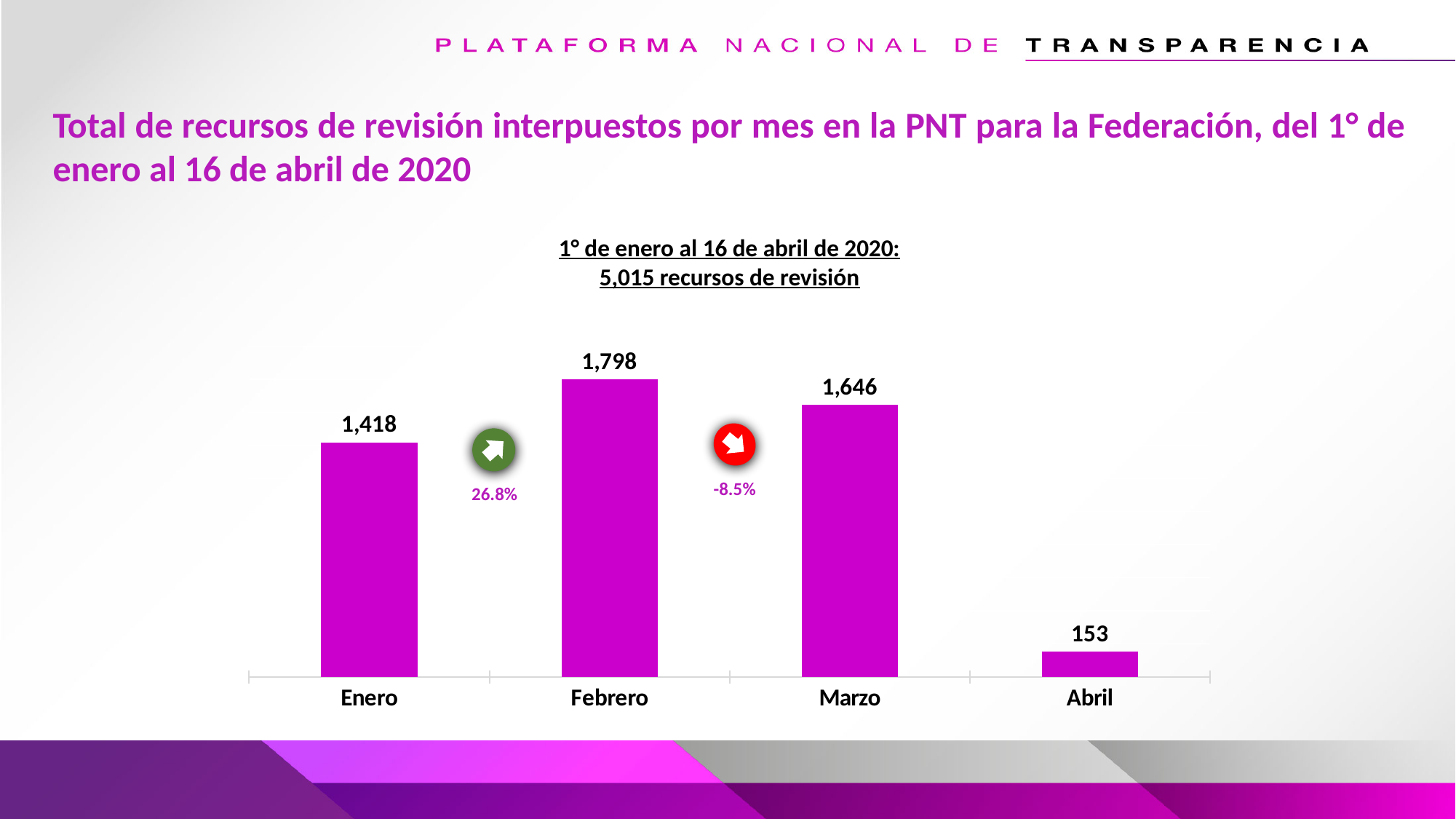
What is the value for Enero? 1,418 What is the difference between the values for Febrero and Enero? 380 What is the difference between the values for Febrero and Marzo? 152 What is the value for Febrero? 1,798 Which month has the lowest value? Abril Which month has the highest value? Febrero What percentage change is shown between Febrero and Marzo? -8.5% What is the value for Abril? 153 How many months are shown on the chart? 4 What is the value for Marzo? 1,646 Which is larger, the value for Enero or the value for Marzo? Marzo What kind of chart is shown on the slide? Bar chart